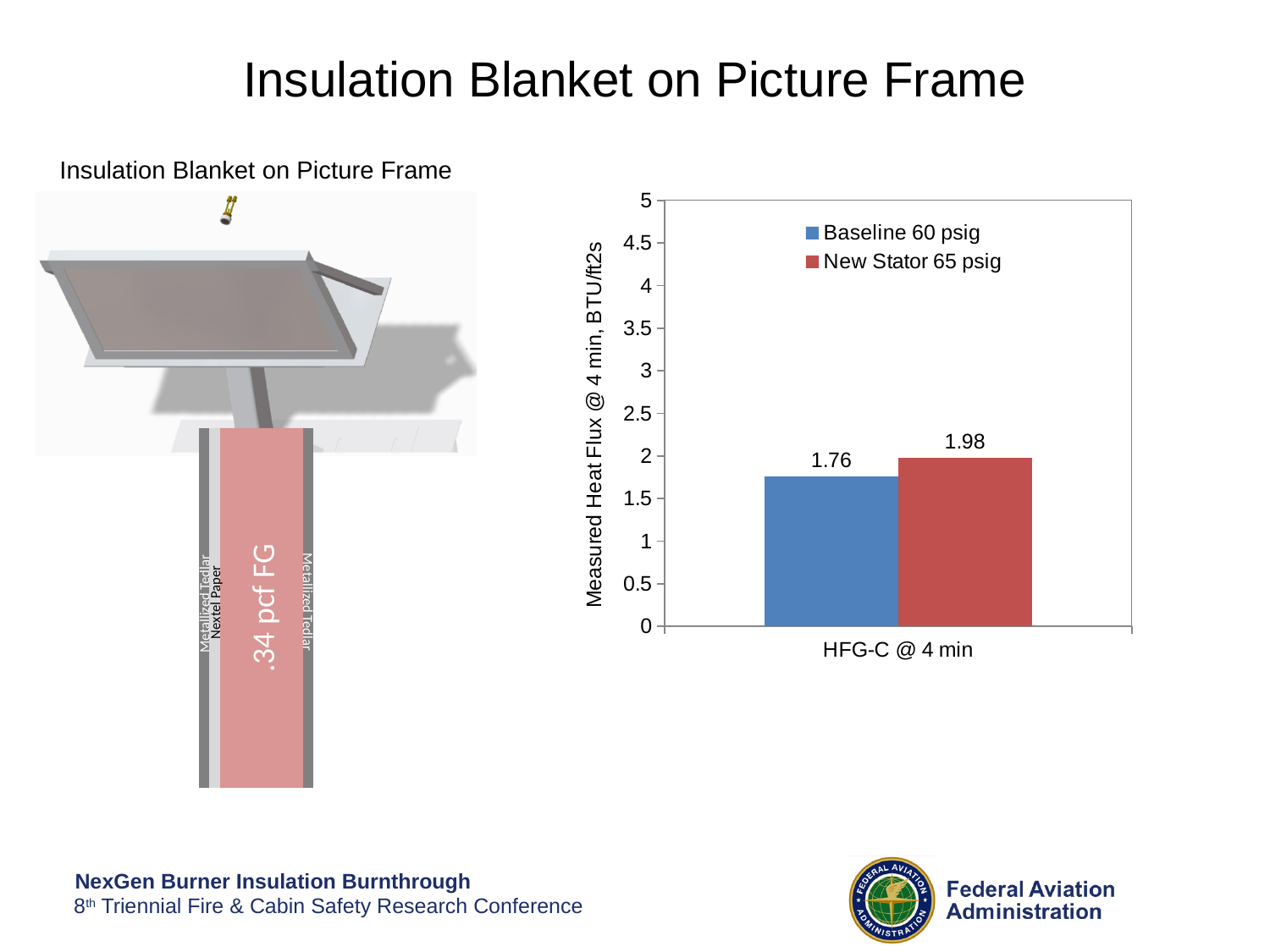
Which series has the lower measured heat flux at HFG-C @ 4 min? Baseline 60 psig How many series does the chart legend list? 2 What kind of chart is shown on the slide? bar chart Is the Baseline 60 psig value larger or smaller than the New Stator 65 psig value? smaller What is the measured heat flux for New Stator 65 psig at HFG-C @ 4 min? 1.98 How many categories are shown on the x axis of the chart? 1 What is the difference between the New Stator 65 psig and Baseline 60 psig heat flux values? 0.22 Is the value for New Stator 65 psig greater or less than 2? less Is the value for Baseline 60 psig greater or less than 1.5? greater What is the measured heat flux for Baseline 60 psig at HFG-C @ 4 min? 1.76 What is the label of the y axis of the chart? Measured Heat Flux @ 4 min, BTU/ft2s Which series has the higher measured heat flux at HFG-C @ 4 min? New Stator 65 psig